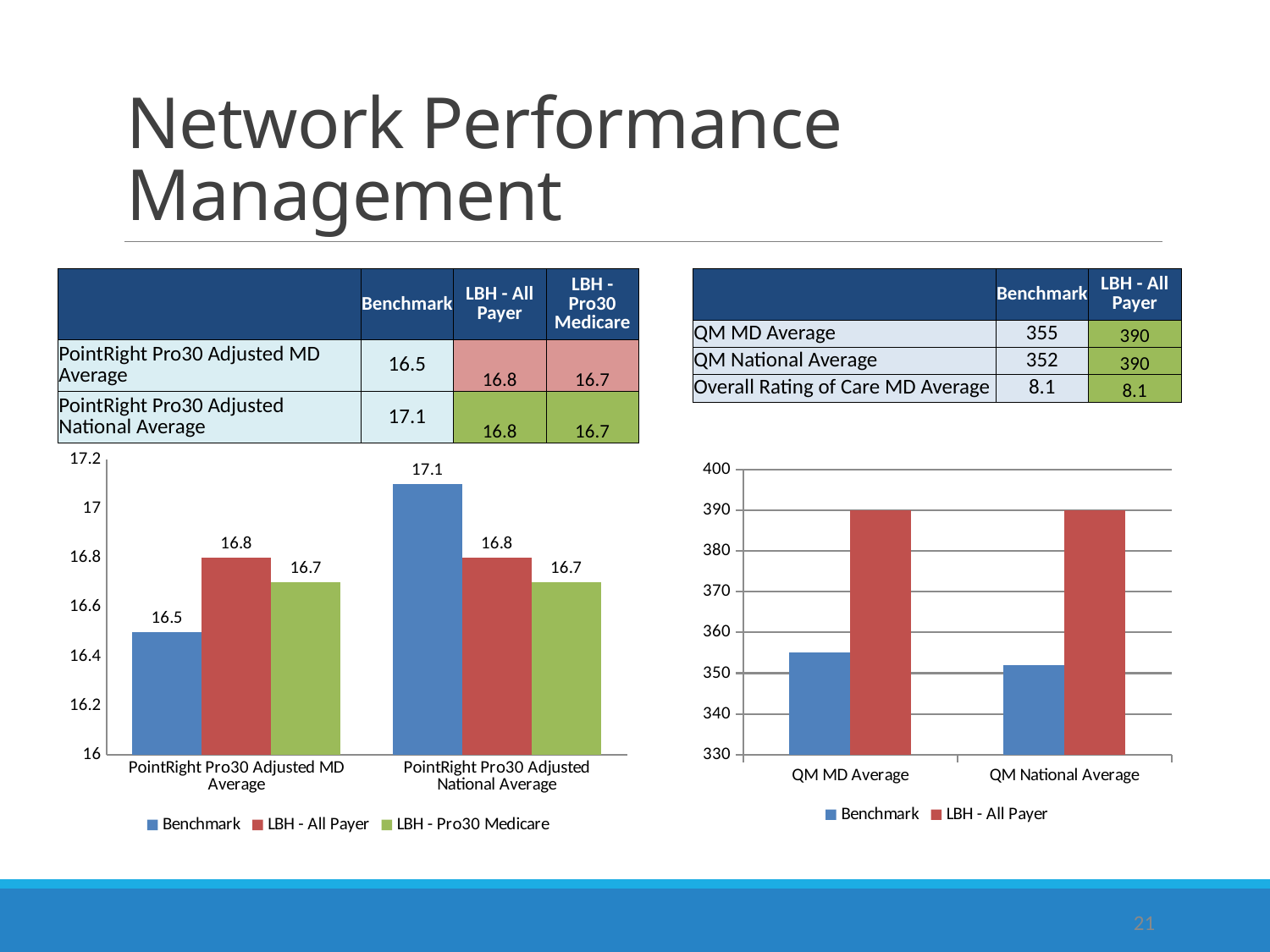
In the left chart, what is the difference between the Benchmark values for PointRight Pro30 Adjusted National Average and PointRight Pro30 Adjusted MD Average? 0.6 In the right chart, how many categories are shown on the x axis? 2 In the right chart, is the Benchmark value for QM National Average greater or less than 360? less In the right chart, which series is larger for QM MD Average, Benchmark or LBH - All Payer? LBH - All Payer What kind of chart is the left chart? Bar chart In the left chart, what is the LBH - All Payer value for PointRight Pro30 Adjusted MD Average? 16.8 In the left chart, what is the LBH - Pro30 Medicare value for PointRight Pro30 Adjusted MD Average? 16.7 In the left chart, which series has the highest value for PointRight Pro30 Adjusted National Average? Benchmark In the left chart, what is the Benchmark value for PointRight Pro30 Adjusted National Average? 17.1 In the left chart, which series has the lowest value for PointRight Pro30 Adjusted MD Average? Benchmark In the right chart, what is the LBH - All Payer value for QM MD Average? 390 In the left chart, how many series does the legend list? 3